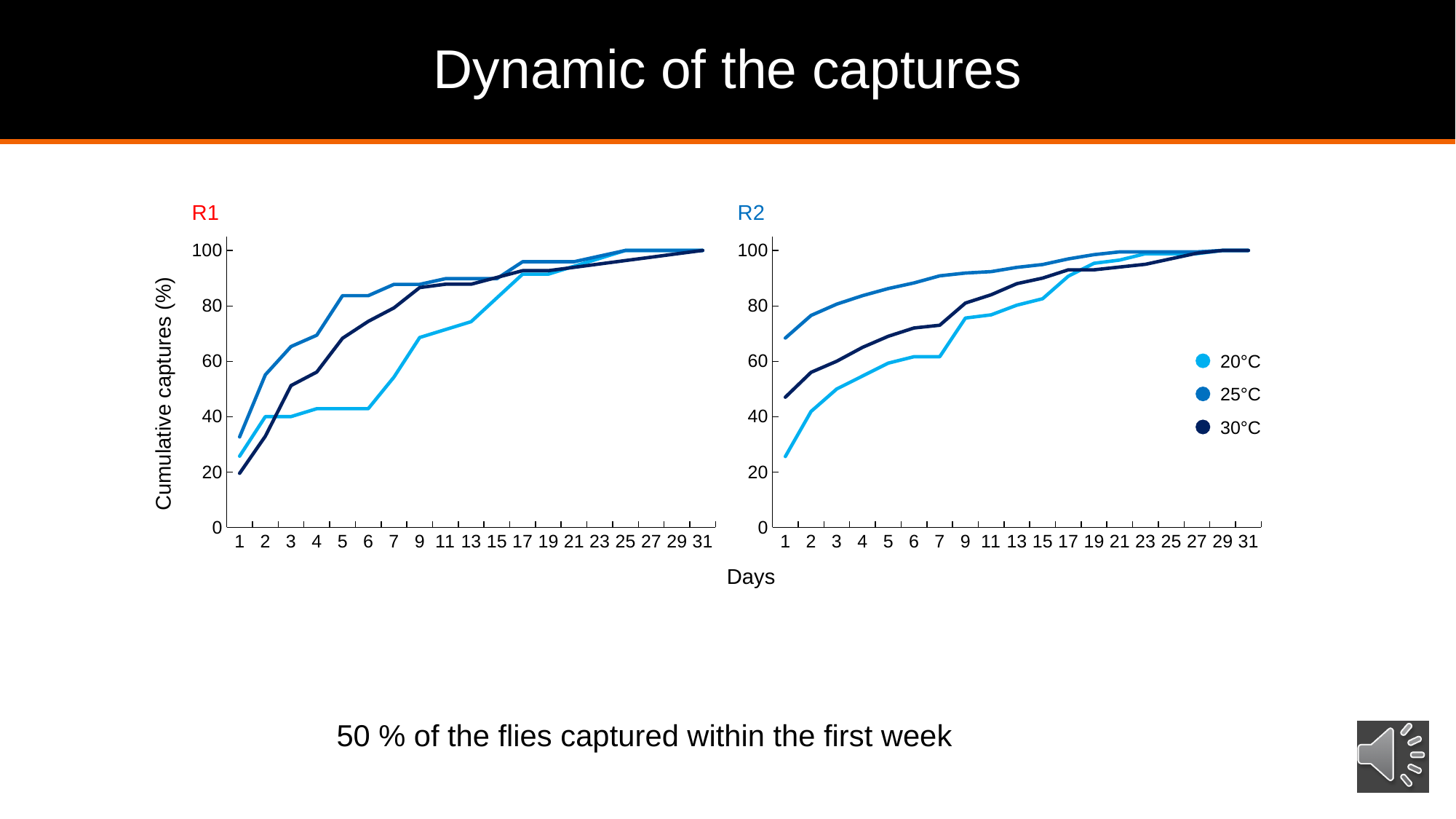
In the R2 chart, is the value for 25°C at day 1 greater or less than 60? greater In the R1 chart, is the value for 20°C at day 6 greater or less than 60? less In the R2 chart, is the value for 20°C at day 1 greater or less than 40? less In the R2 chart, what is the cumulative captures value for 30°C at day 31? 100 What kind of chart is the R1 chart? line chart What is the label of the y axis on the charts? Cumulative captures (%) In the R1 chart, what is the cumulative captures value for 20°C at day 31? 100 In the R2 chart, which series has the lowest value at day 1? 20°C How many series does the legend list for the charts? 3 In the R1 chart, which series has the larger value at day 6, 25°C or 20°C? 25°C In the R2 chart, which series has the highest value at day 1? 25°C In the R2 chart, do the values for 30°C rise or fall as the days increase? rise